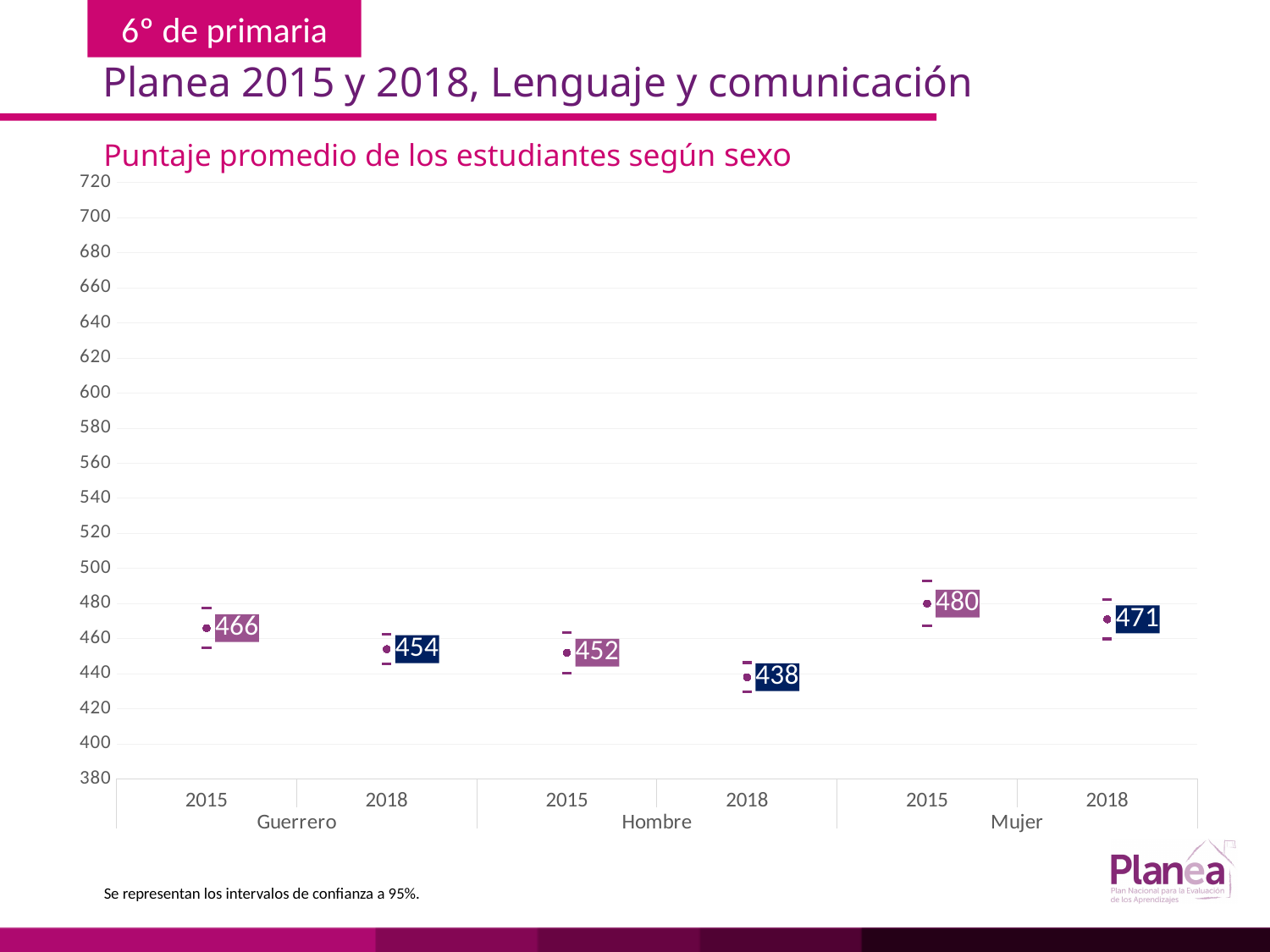
What is the average score for Mujer in 2015? 480 What is the average score for Mujer in 2018? 471 What is the average score for Hombre in 2018? 438 Did the average score for Hombre rise or fall from 2015 to 2018? Fall By how much did the Guerrero average score change from 2015 to 2018? 12 What is the average score for Guerrero in 2015? 466 What is the title of the chart? Puntaje promedio de los estudiantes según sexo How many data points are plotted on the chart? 6 What is the difference between the Mujer 2015 score and the Hombre 2015 score? 28 Which is larger, the Guerrero 2018 score or the Hombre 2015 score? Guerrero 2018 Which group and year has the lowest average score? Hombre 2018 Which group and year has the highest average score? Mujer 2015